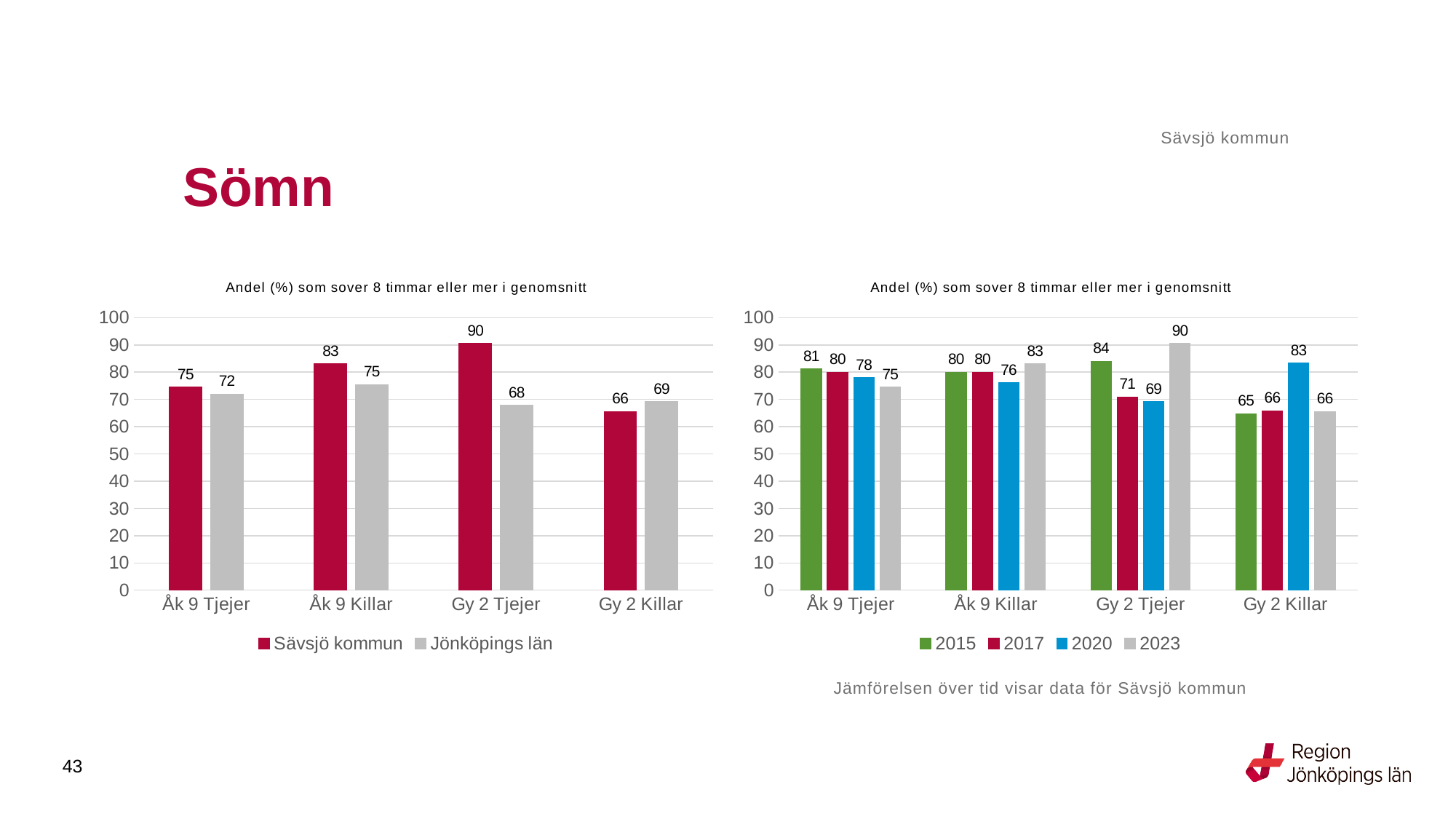
What kind of chart is the right chart? Bar chart In the left chart, which category has the lowest value for Jönköpings län? Gy 2 Tjejer How many categories are shown on the x axis of the left chart? 4 In the right chart, what is the value for 2020 for Gy 2 Killar? 83 In the left chart, which is larger for Gy 2 Killar: Sävsjö kommun or Jönköpings län? Jönköpings län In the right chart, what is the difference between the 2023 and 2017 values for Gy 2 Tjejer? 19 In the left chart, what is the value for Jönköpings län for Åk 9 Killar? 75 In the right chart, what is the value for 2015 for Gy 2 Tjejer? 84 In the left chart, what is the difference between Sävsjö kommun and Jönköpings län for Gy 2 Tjejer? 22 How many series does the legend of the right chart list? 4 In the left chart, which category has the highest value for Sävsjö kommun? Gy 2 Tjejer In the left chart, what is the value for Sävsjö kommun for Gy 2 Tjejer? 90